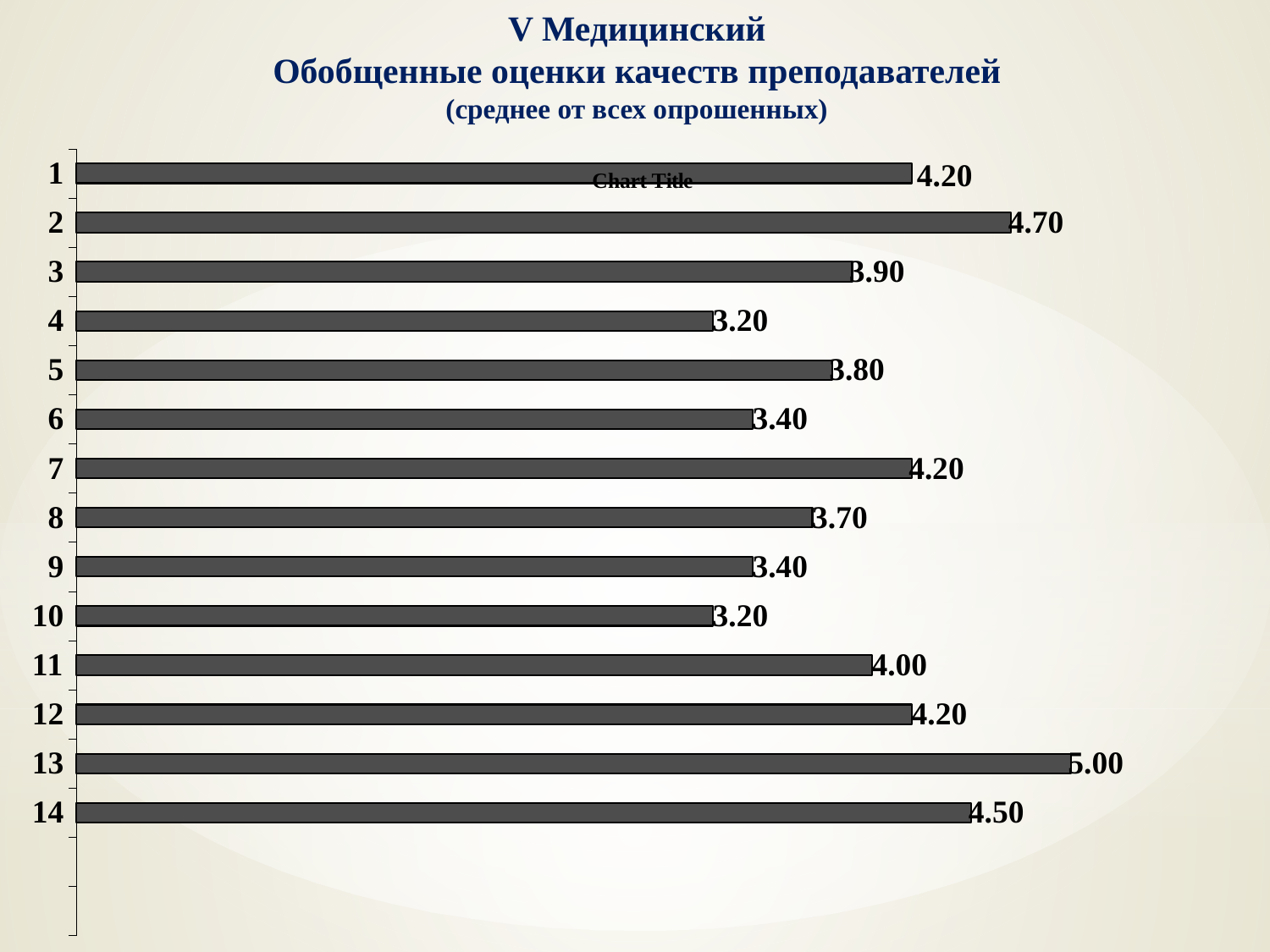
What is the value for category 11? 4.00 What is the difference between the values for category 13 and category 4? 1.80 What is the value for category 8? 3.70 Which is larger, the value for category 5 or the value for category 6? category 5 What is the lowest value shown on the chart? 3.20 What is the difference between the values for category 14 and category 3? 0.60 What kind of chart is shown on the slide? bar chart What is the value for category 2? 4.70 How many categories are plotted on the chart? 14 What is the value for category 13? 5.00 Which category has the highest value? 13 Which is larger, the value for category 2 or the value for category 14? category 2